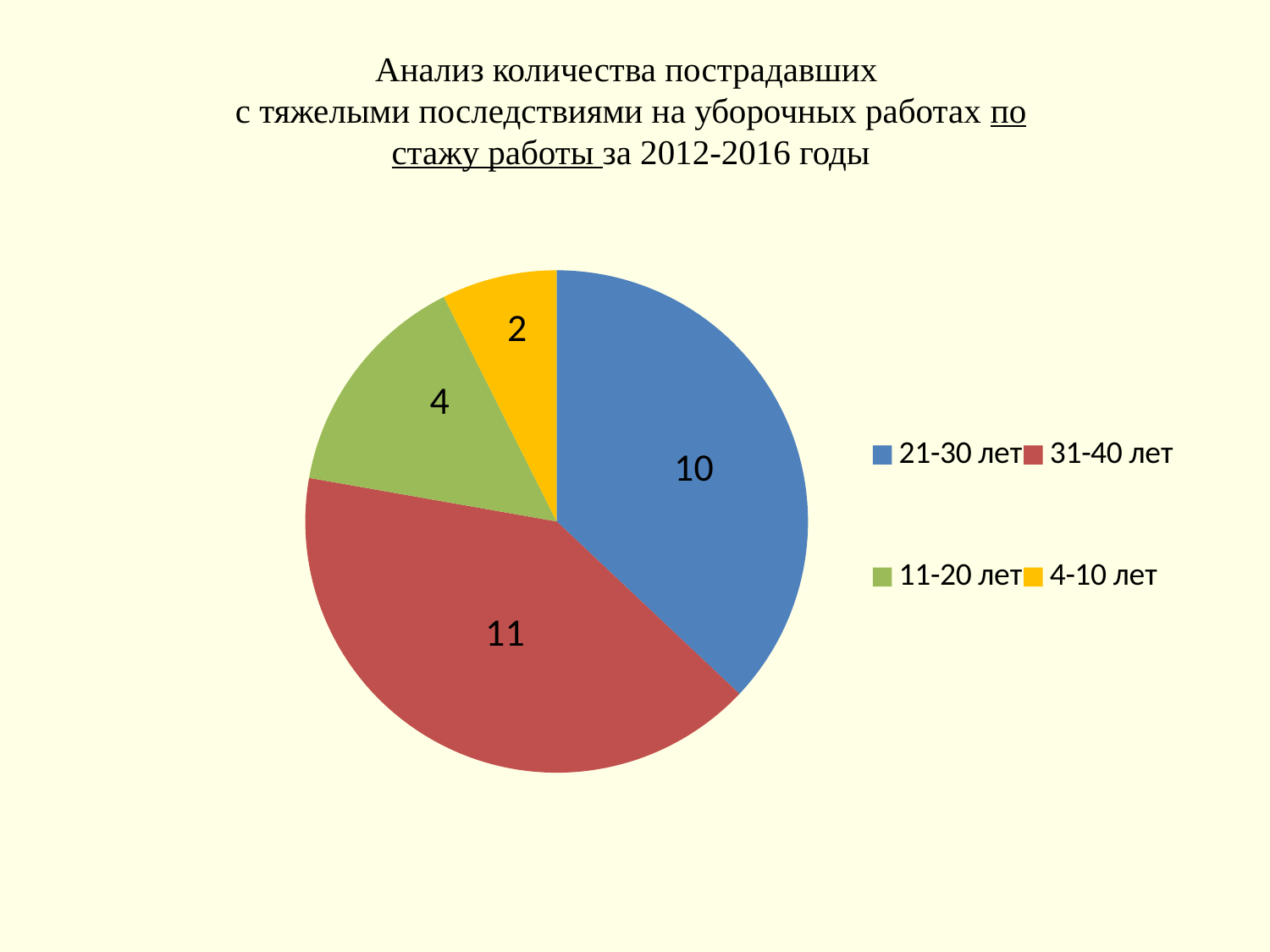
What share of the total does the 11-20 лет slice represent? 4 of 27 Which category has the smallest slice? 4-10 лет What is the value for the 31-40 лет slice? 11 What kind of chart is shown on the slide? pie chart What colour is the 31-40 лет slice? red What is the value for the 11-20 лет slice? 4 How many categories does the pie chart have? 4 Which category has the largest slice? 31-40 лет What is the value for the 21-30 лет slice? 10 What is the value for the 4-10 лет slice? 2 Which is larger, the value for 11-20 лет or the value for 4-10 лет? 11-20 лет What is the difference between the values for 31-40 лет and 11-20 лет? 7